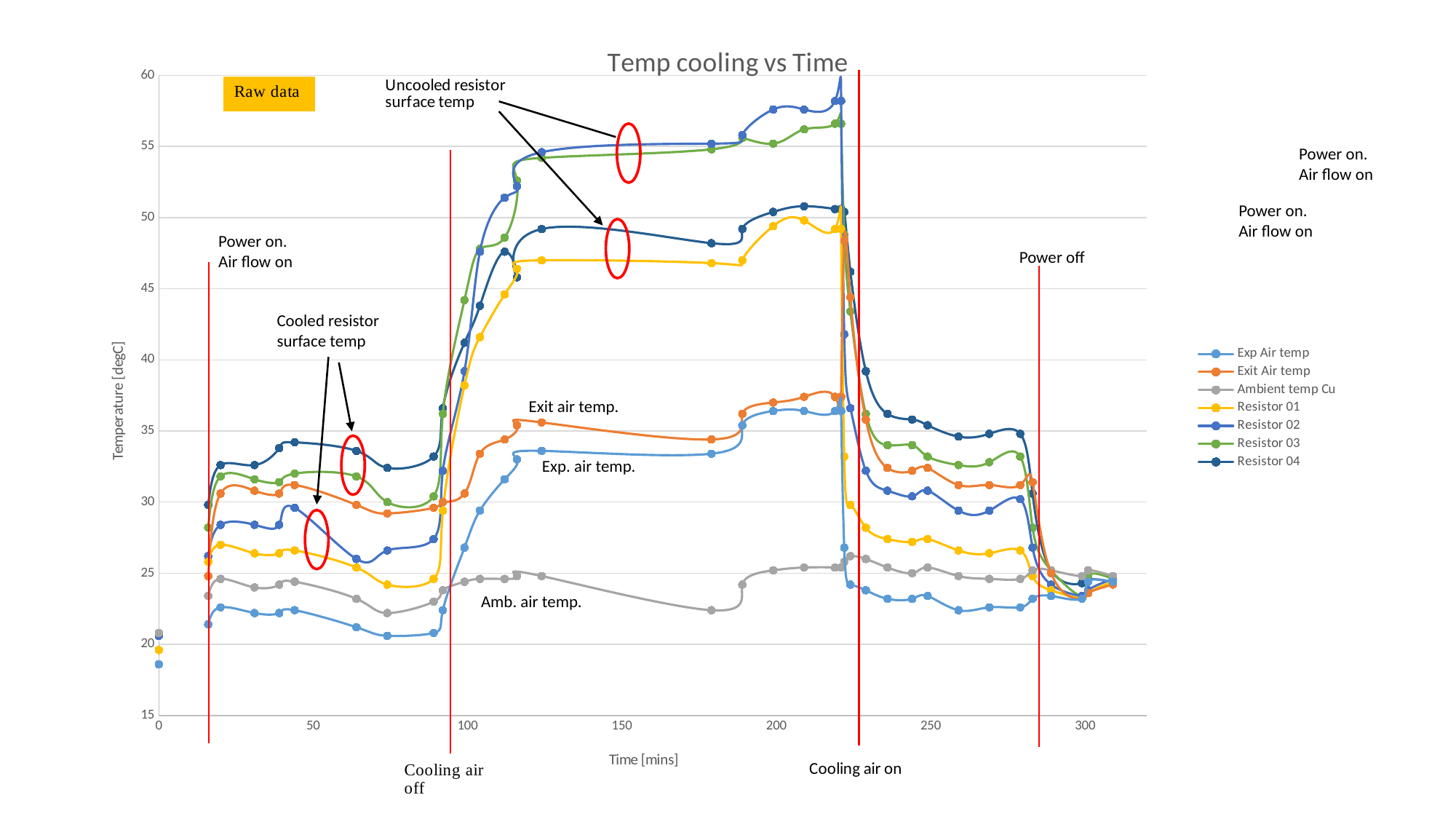
What is the label of the vertical axis? Temperature [degC] At 150 mins, which is larger: Resistor 03 or Resistor 01? Resistor 03 Is the value for Ambient temp Cu at 180 mins greater or less than 25? less Does the value for Resistor 01 rise or fall between 100 and 120 mins? rise Which series has the highest value at 150 mins? Resistor 02 Is the value for Resistor 03 at 200 mins greater or less than 50? greater Is the value for Resistor 04 at 50 mins greater or less than 30? greater Which series has the lowest value at 180 mins? Ambient temp Cu How many series does the legend list? 7 What kind of chart is shown on the slide? line chart What is the title of the chart? Temp cooling vs Time